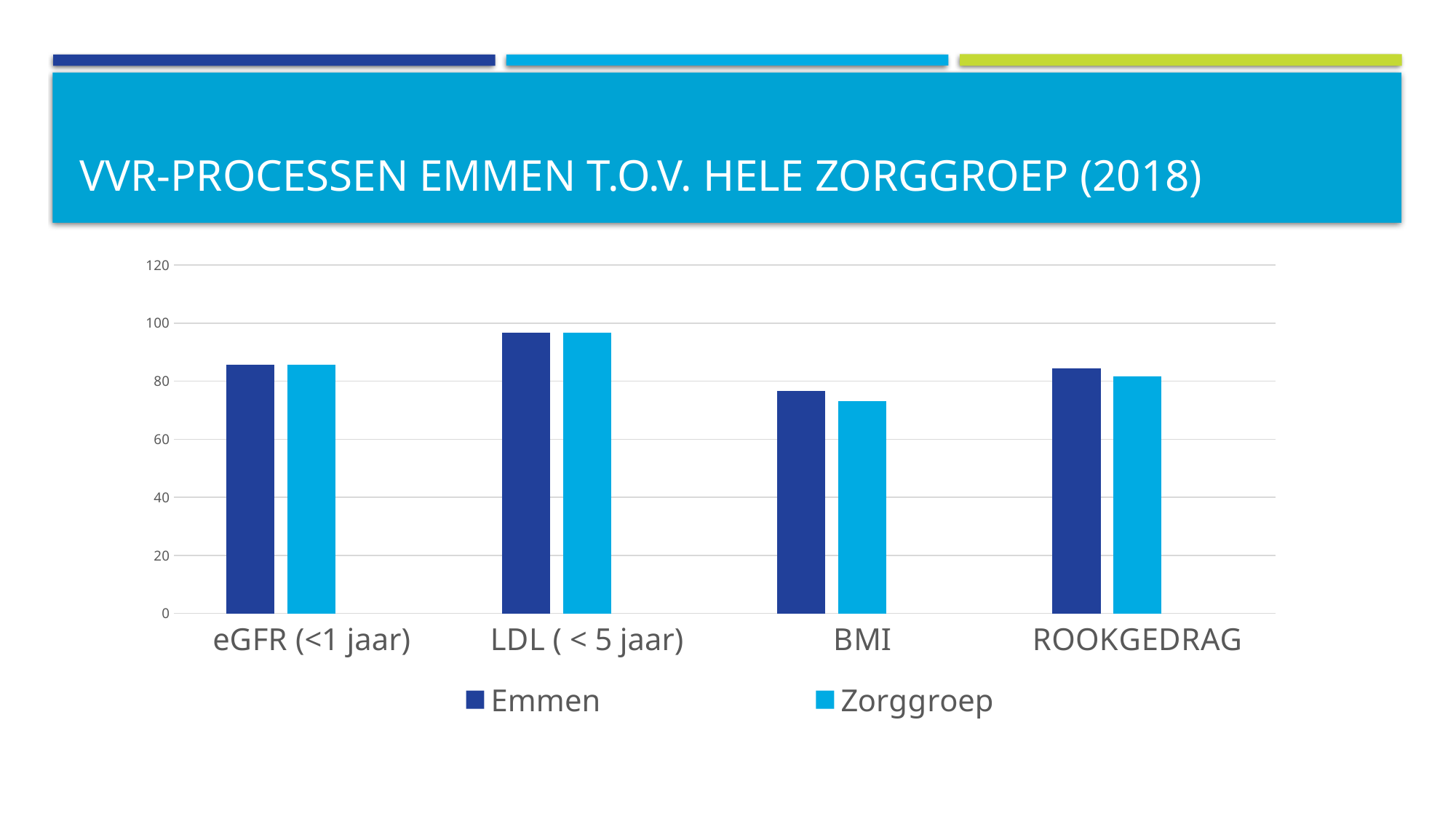
Which category has the highest value for the Emmen series? LDL ( < 5 jaar) Is the Emmen value for eGFR (<1 jaar) greater or less than 100? less Is the Zorggroep value for BMI greater or less than 80? less What is the title of the chart on the slide? VVR-PROCESSEN EMMEN T.O.V. HELE ZORGGROEP (2018) Which series is shown in dark blue in the chart's legend? Emmen What kind of chart is shown on the slide? bar chart Is the Emmen value for LDL ( < 5 jaar) greater or less than 80? greater How many categories are shown on the x axis of the chart? 4 How many series does the chart's legend list? 2 For BMI, which series has the larger value, Emmen or Zorggroep? Emmen Which category has the lowest value for the Zorggroep series? BMI Which category has the lowest value for the Emmen series? BMI